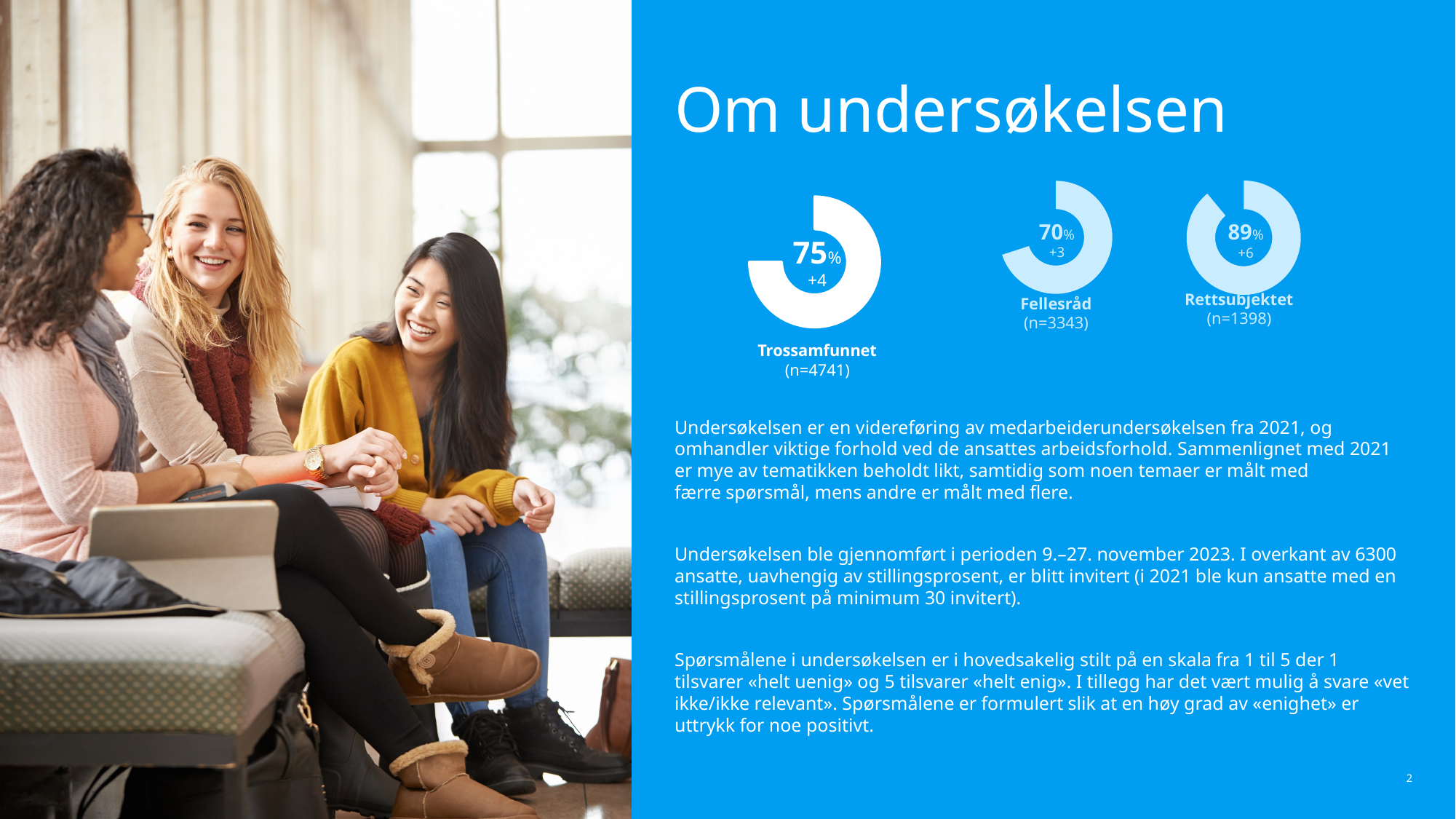
What is the difference in percentage points between the Rettsubjektet and Fellesråd donut charts? 19 How many donut charts are shown on the slide? 3 What sample size (n) is given under the Fellesråd donut chart? n=3343 What change from the previous survey is shown under the percentage in the Trossamfunnet donut chart? +4 What change from the previous survey is shown under the percentage in the Rettsubjektet donut chart? +6 Which is larger, the percentage in the Trossamfunnet chart or the percentage in the Fellesråd chart? Trossamfunnet What percentage is shown in the Rettsubjektet donut chart? 89% Which of the three donut charts shows the lowest percentage? Fellesråd What percentage is shown in the Trossamfunnet donut chart? 75% What percentage is shown in the Fellesråd donut chart? 70% Which of the three donut charts shows the highest percentage? Rettsubjektet What kind of chart is used to show the percentages on the slide? Donut chart